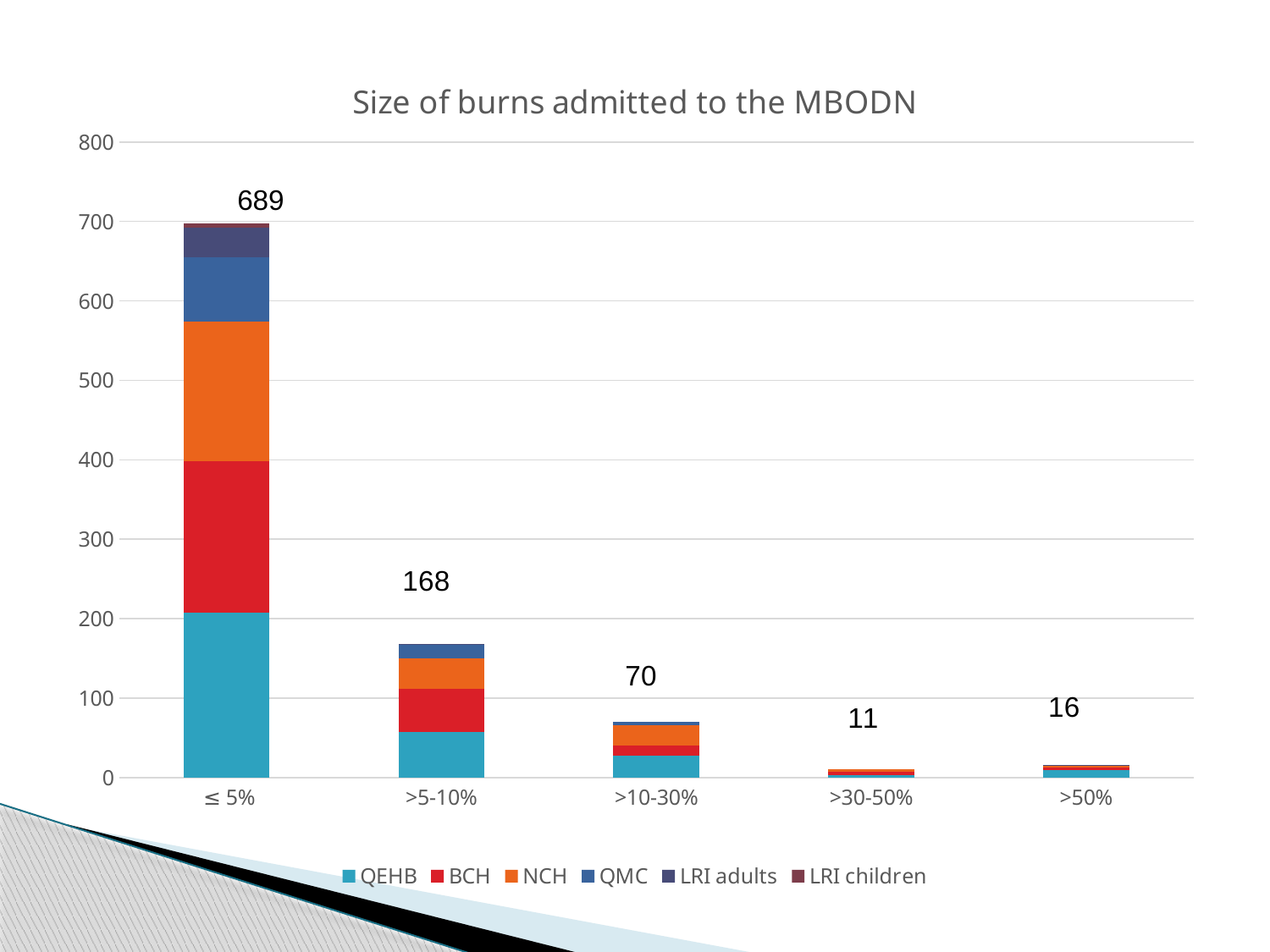
Which category has the larger total, >30-50% or >50%? >50% Which burn size category has the highest total? ≤ 5% What is the total labelled above the >5-10% bar? 168 How many burn size categories are shown on the x axis? 5 What is the difference between the totals for >50% and >30-50%? 5 Which burn size category has the lowest total? >30-50% Is the QEHB segment of the ≤ 5% bar greater or less than 100? greater How many series does the legend list? 6 What is the difference between the totals for ≤ 5% and >5-10%? 521 What kind of chart is shown on the slide? Stacked bar chart What is the total number of burns admitted in the ≤ 5% category? 689 What is the total for the >10-30% burn size category? 70